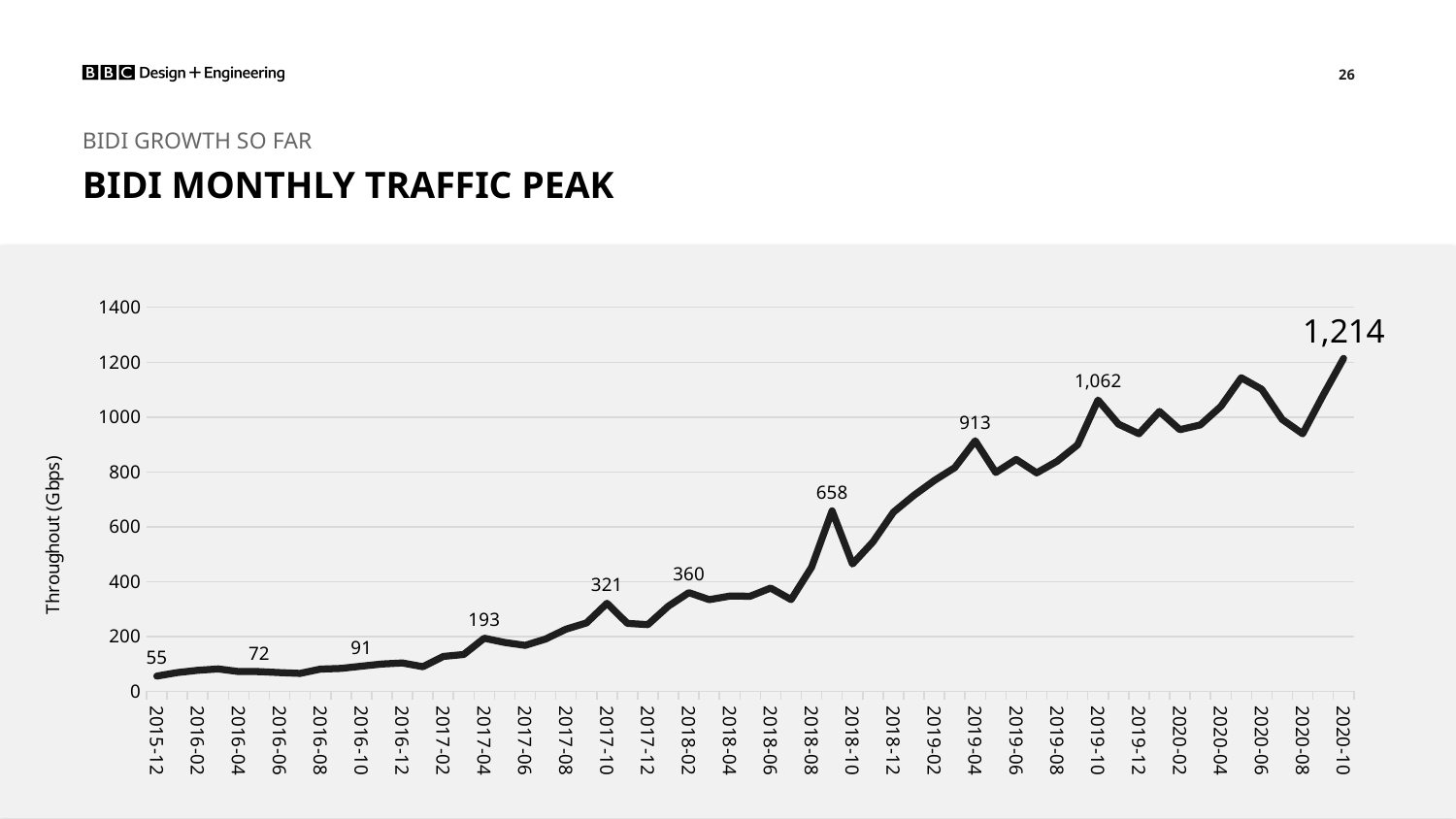
What type of chart is shown on the slide? line chart Which is larger, the throughput in 2019-10 or in 2019-04? 2019-10 Which month has the lowest throughput value? 2015-12 What is the throughput value for 2020-10? 1,214 What is the throughput value for 2019-04? 913 What is the throughput value for 2015-12? 55 What is the label on the vertical axis? Throughput (Gbps) What is the throughput value for 2017-04? 193 What is the difference between the throughput in 2020-10 and in 2015-12? 1,159 What is the throughput value for 2017-10? 321 Which month has the highest throughput value? 2020-10 Is the value for 2020-08 greater or less than 1000? less